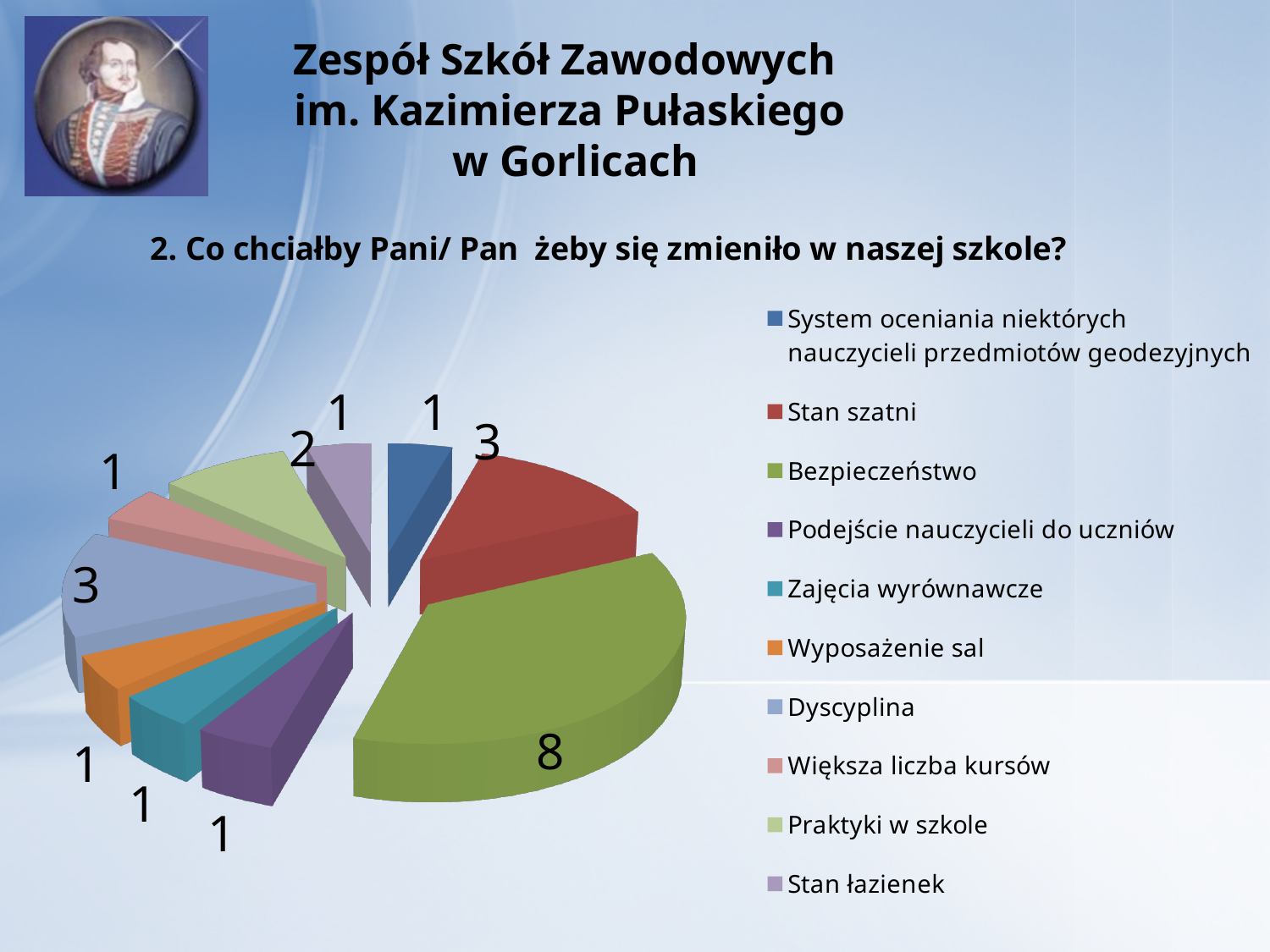
What kind of chart is shown on the slide? Pie chart Which is larger, the value for Praktyki w szkole or the value for Stan łazienek? Praktyki w szkole What is the difference between the values for Bezpieczeństwo and Stan szatni? 5 What is the total of all the values shown in the pie chart? 22 How many slices does the pie chart have? 10 What is the value for Dyscyplina in the pie chart? 3 What is the value for Bezpieczeństwo in the pie chart? 8 How many entries does the legend of the pie chart list? 10 Which category has the largest slice in the pie chart? Bezpieczeństwo What is the value for Stan szatni in the pie chart? 3 What is the value for Praktyki w szkole in the pie chart? 2 What colour is the slice for Bezpieczeństwo in the pie chart? Green